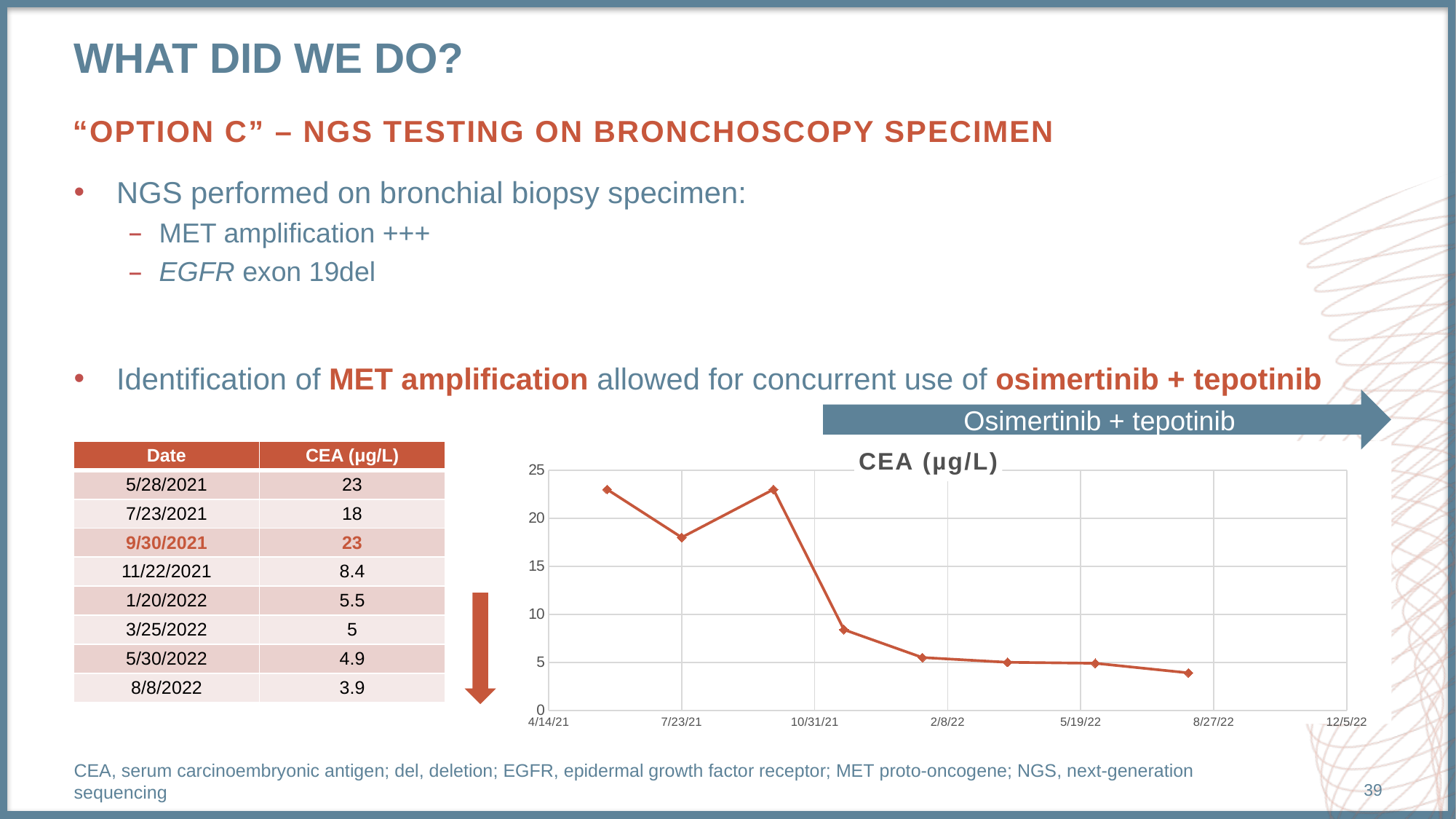
What is the difference between the CEA value on 9/30/2021 and the value on 11/22/2021? 14.6 Which is larger, the CEA value on 5/28/2021 or the value on 7/23/2021? 5/28/2021 What is the title of the chart? CEA (µg/L) According to the slide, what was the CEA value on 11/22/2021? 8.4 Overall, do the CEA values rise or fall over time on the chart? fall Is the CEA value on 7/23/2021 greater or less than 15? greater Which date has the lowest CEA value? 8/8/2022 What is the maximum value shown on the y axis of the chart? 25 What kind of chart is shown on the slide? line chart How many data points are plotted on the CEA (µg/L) line chart? 8 According to the slide, what was the CEA value on 8/8/2022? 3.9 Is the CEA value on 1/20/2022 greater or less than 10? less